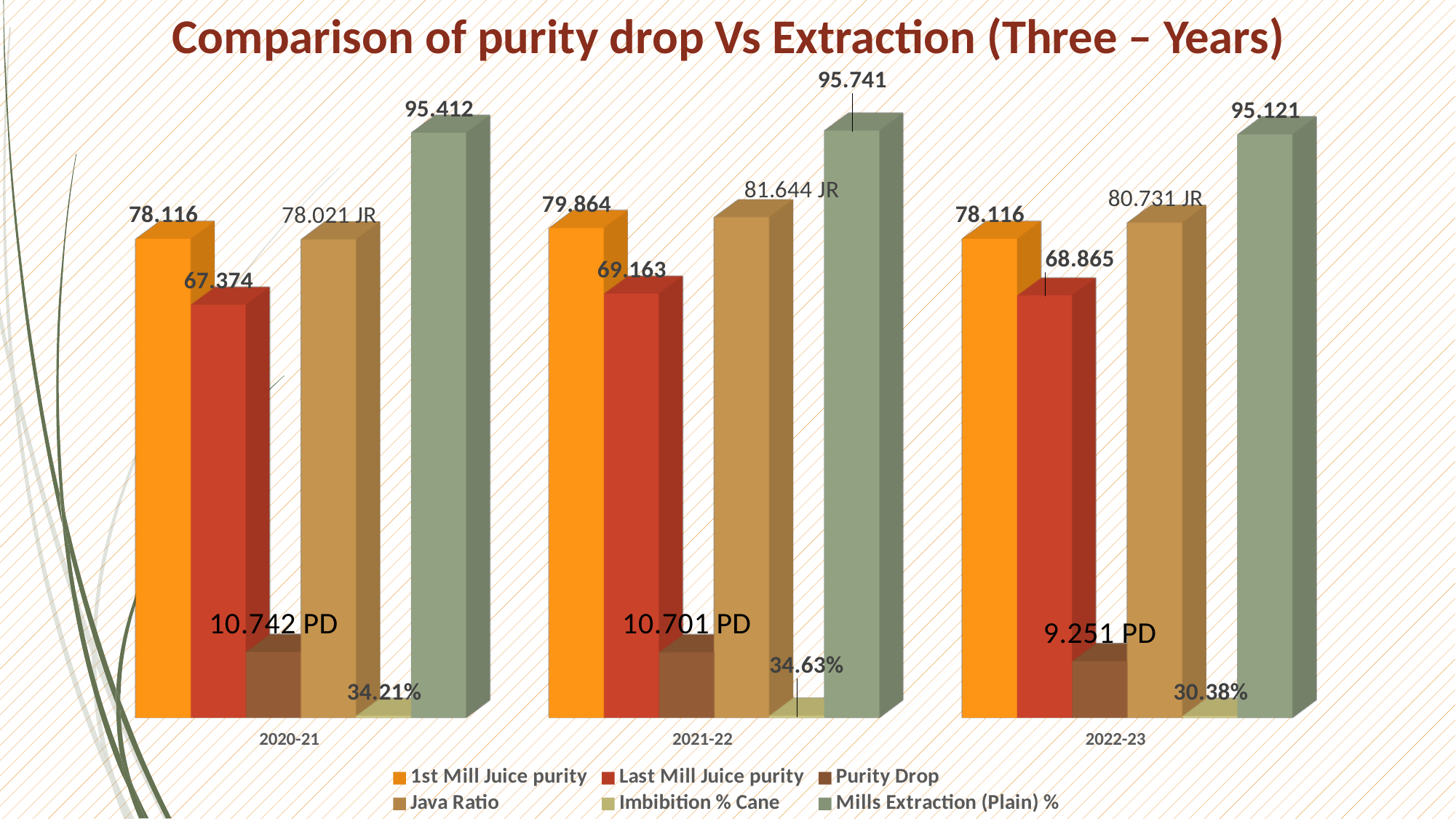
What is the Mills Extraction (Plain) % value for 2021-22? 95.741 Does the Purity Drop value rise or fall from 2020-21 to 2022-23? fall Which year has the larger Java Ratio, 2021-22 or 2022-23? 2021-22 What is the Last Mill Juice purity value for 2020-21? 67.374 Which year has the highest Mills Extraction (Plain) % value? 2021-22 What kind of chart is shown on the slide? bar chart What is the Purity Drop value labelled for 2022-23? 9.251 PD What is the Imbibition % Cane value for 2021-22? 34.63% How many year categories are shown on the x axis? 3 Which year has the lowest Purity Drop value? 2022-23 How many series does the legend list? 6 How much higher is the 1st Mill Juice purity in 2021-22 than in 2020-21? 1.748